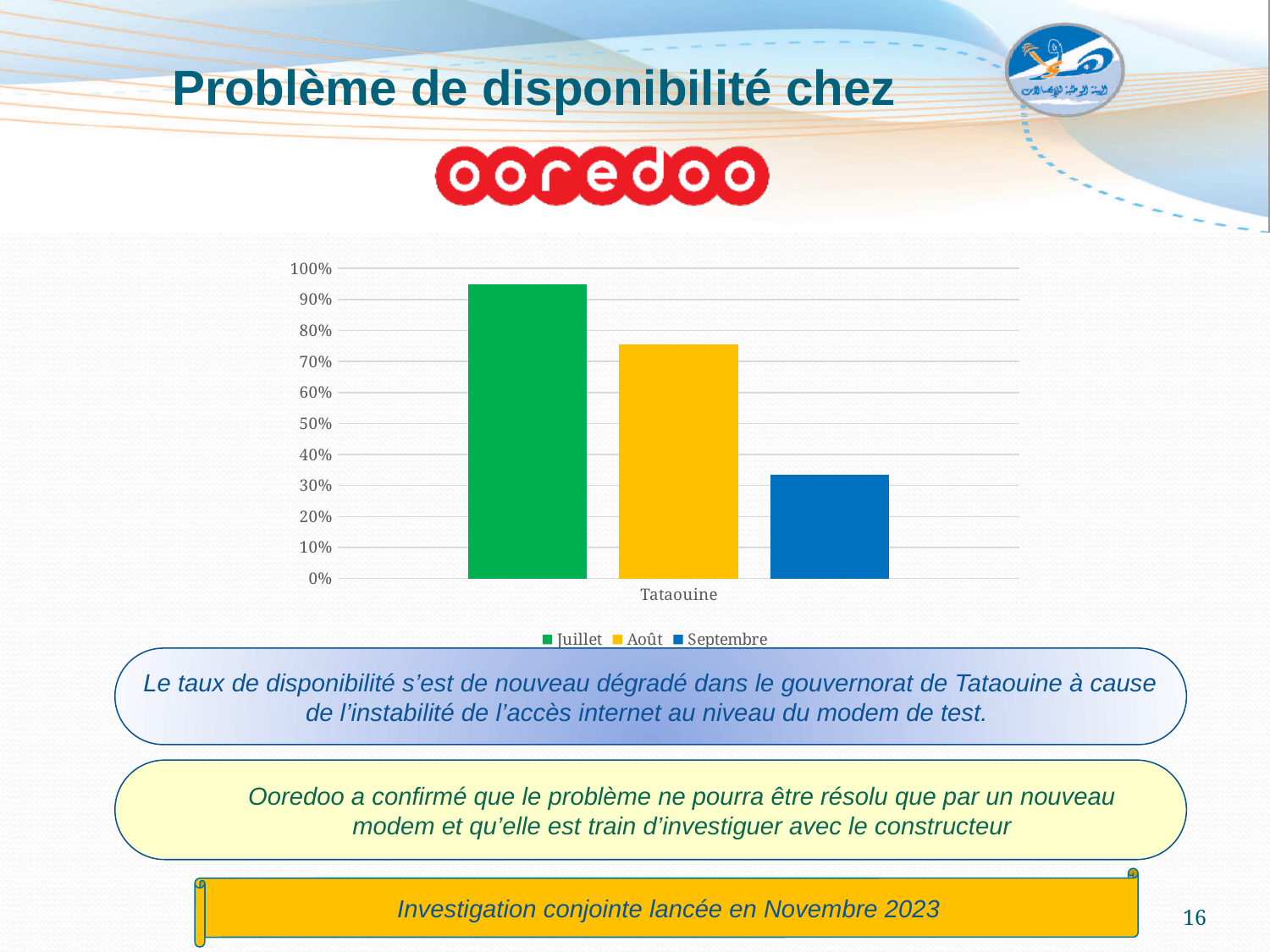
Is the value for Août greater or less than 80%? less Do the values rise or fall from Juillet to Septembre? fall How many series does the chart legend list? 3 How many categories are shown on the x axis of the chart? 1 What colour is the bar for Septembre? blue Which is larger for Tataouine, the value for Août or the value for Septembre? Août Is the value for Septembre greater or less than 40%? less Which series has the lowest value for Tataouine? Septembre What kind of chart is shown on the slide? bar chart Which series has the highest value for Tataouine? Juillet Is the value for Juillet greater or less than 90%? greater